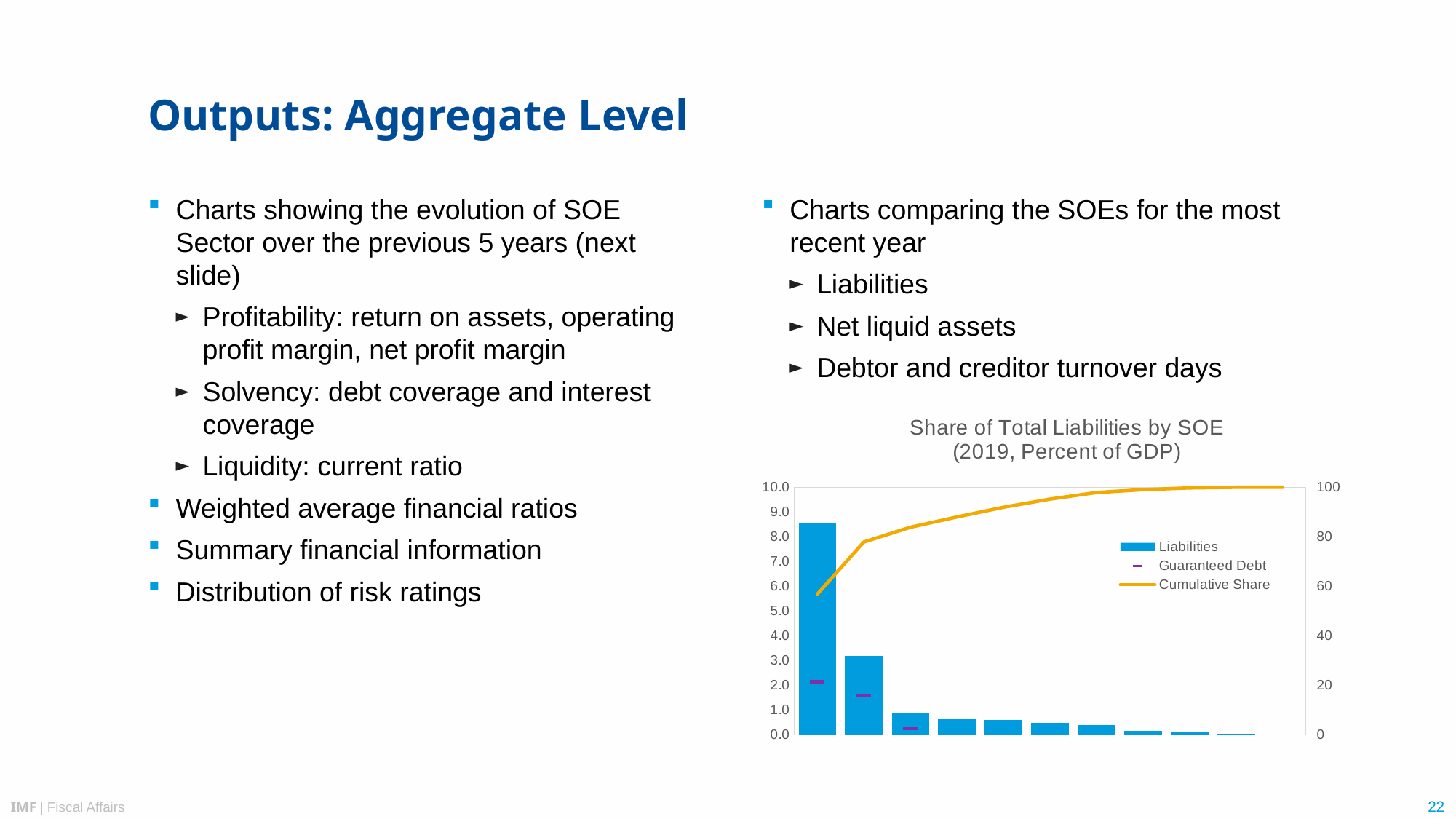
What kind of chart is shown on the slide? A combined bar and line chart What is the title of the chart on the slide? Share of Total Liabilities by SOE (2019, Percent of GDP) Does the Cumulative Share line rise or fall from left to right? Rise Do the Liabilities bars rise or fall from left to right across the chart? Fall How many series does the chart's legend list? 3 Which bar has the highest Liabilities value, the leftmost bar or the rightmost bar? The leftmost bar How many bars are plotted in the chart? 10 Which series are listed in the chart's legend? Liabilities, Guaranteed Debt, Cumulative Share Is the Liabilities value of the tallest (leftmost) bar greater or less than 8.0? greater Is the Cumulative Share value at the first SOE greater or less than 40 on the right-hand axis? greater Is the Liabilities value of the second bar from the left greater or less than 4.0? less